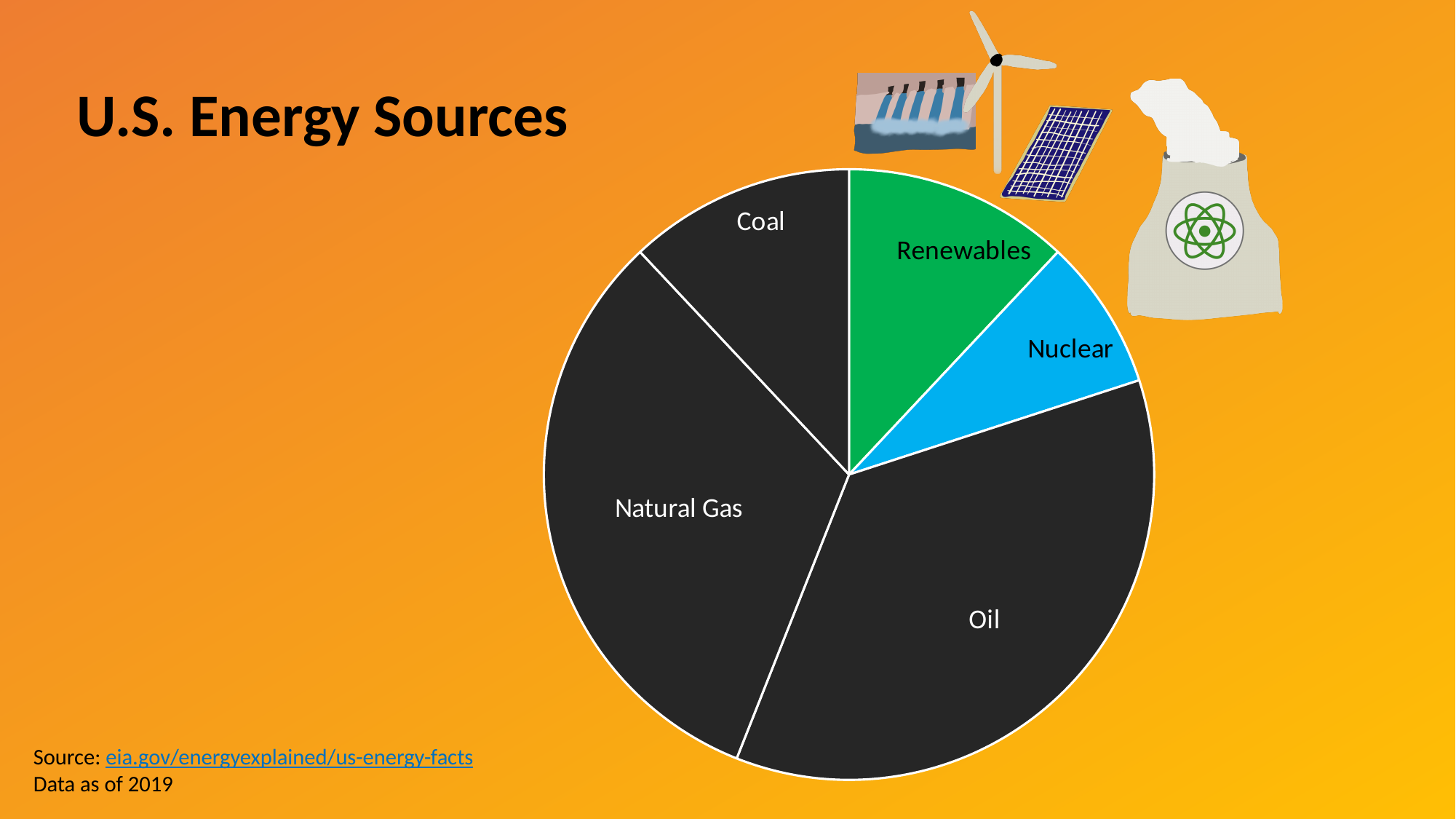
How many slices does the pie chart have? 5 Which slice is larger, Natural Gas or Coal? Natural Gas Which slice is larger, Natural Gas or Renewables? Natural Gas What is the title of the slide containing the pie chart? U.S. Energy Sources Which energy source has the smallest slice of the pie chart? Nuclear Which slice is larger, Renewables or Nuclear? Renewables Which energy source has the largest slice of the pie chart? Oil Which slice of the pie chart is coloured green? Renewables What kind of chart is shown on the slide? Pie chart